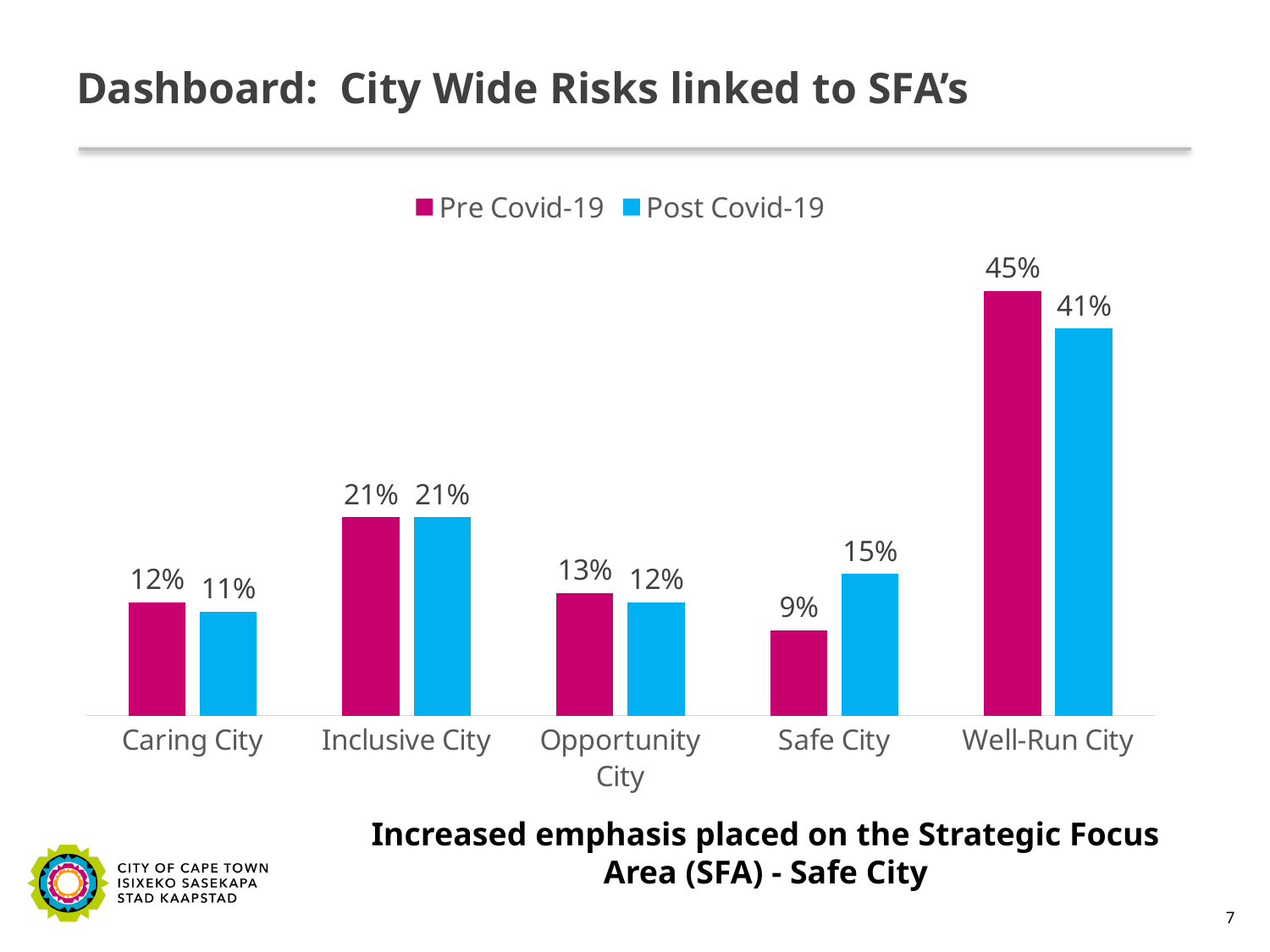
What is the Post Covid-19 value for Caring City? 11% How many categories are shown on the x axis? 5 What is the difference between the Pre Covid-19 and Post Covid-19 values for Safe City? 6% How many series does the legend list? 2 Which colour represents the Post Covid-19 series? Blue What is the Pre Covid-19 value for Well-Run City? 45% What kind of chart is shown on the slide? Bar chart What is the Post Covid-19 value for Safe City? 15% Which is larger for Opportunity City: the Pre Covid-19 value or the Post Covid-19 value? Pre Covid-19 What is the difference between the Pre Covid-19 and Post Covid-19 values for Well-Run City? 4% Which category has the lowest Pre Covid-19 value? Safe City Which category has the highest Pre Covid-19 value? Well-Run City